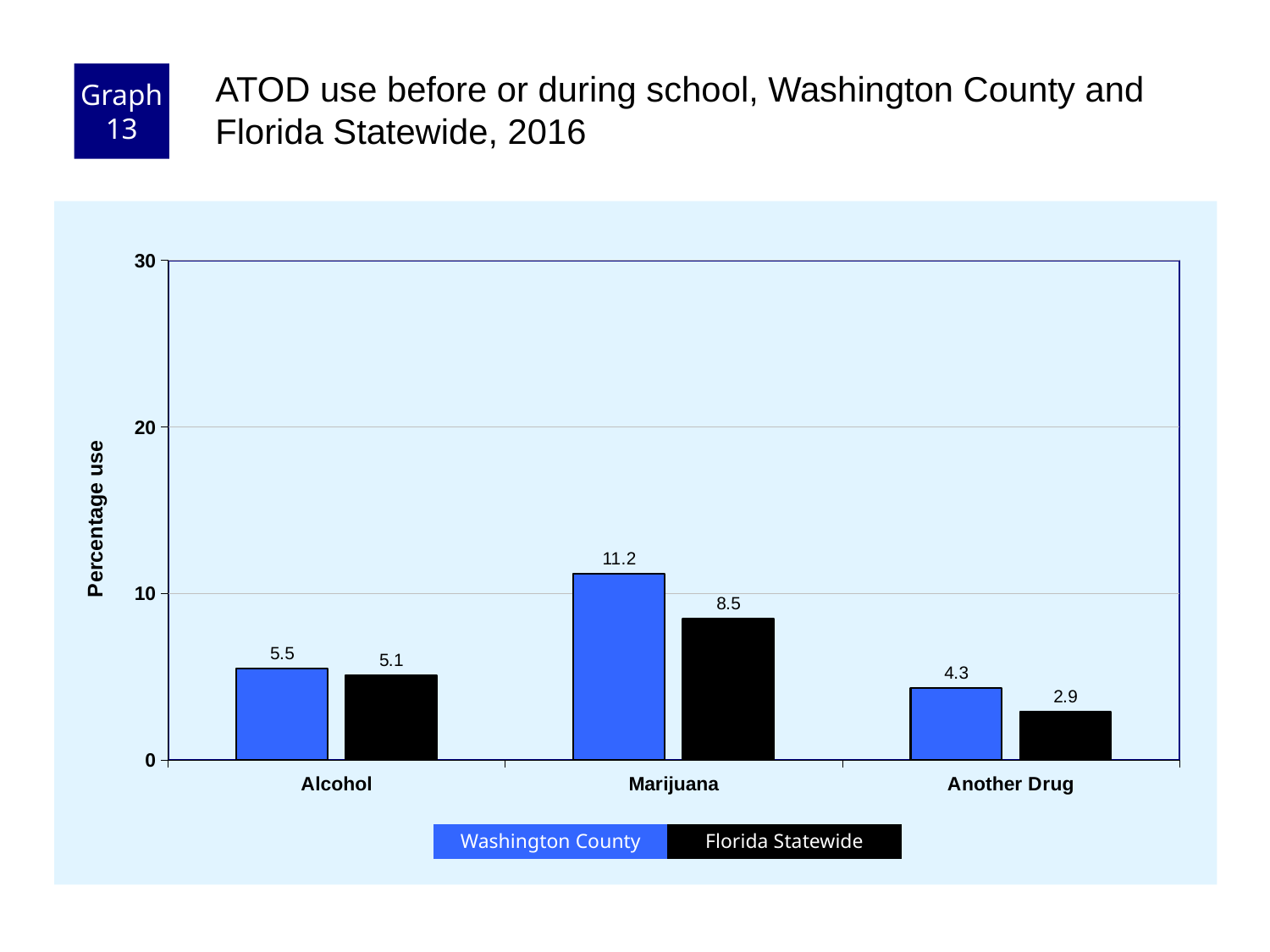
What is the difference between the Washington County and Florida Statewide values for Marijuana? 2.7 Which is larger for Alcohol: the Washington County value or the Florida Statewide value? Washington County Is the Washington County value for Marijuana greater or less than 10? greater What is the Florida Statewide value for Another Drug? 2.9 What kind of chart is shown on the slide? bar chart What is the difference between the Washington County and Florida Statewide values for Another Drug? 1.4 What is the Florida Statewide value for Alcohol? 5.1 Which category has the highest Washington County value? Marijuana What is the Washington County value for Marijuana? 11.2 Which category has the lowest Florida Statewide value? Another Drug How many categories are shown on the x axis? 3 How many series does the legend list? 2